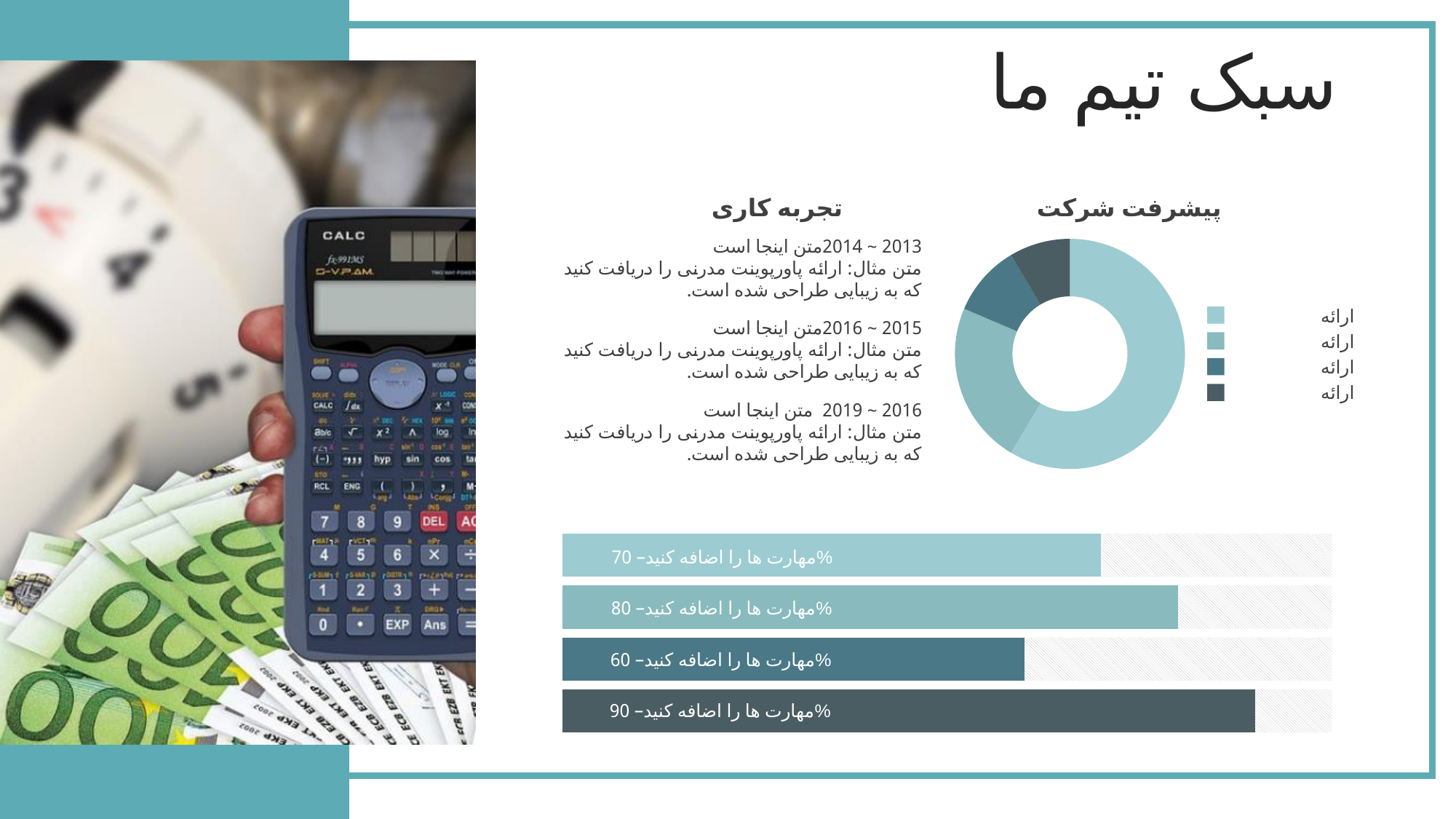
In the bar chart at the bottom of the slide, what is the difference between the highest and lowest bar values? 30% In the bar chart at the bottom of the slide, what value is printed on the top bar? 70% What kind of chart is shown under the title "پیشرفت شرکت"? Donut (pie) chart What label is used for every legend entry of the "پیشرفت شرکت" donut chart? ارائه How many bars are in the horizontal bar chart at the bottom of the slide? 4 What kind of chart is shown at the bottom right of the slide, below the donut chart? Bar chart How many entries does the legend of the "پیشرفت شرکت" donut chart list? 4 In the bar chart at the bottom of the slide, which is larger: the second bar or the third bar? The second bar (80%) In the bar chart at the bottom of the slide, which bar has the lowest value? The third bar (60%) How many slices does the "پیشرفت شرکت" donut chart have? 4 In the bar chart at the bottom of the slide, what value is printed on the bottom bar? 90% In the "پیشرفت شرکت" donut chart, which slice is the largest? The lightest teal slice